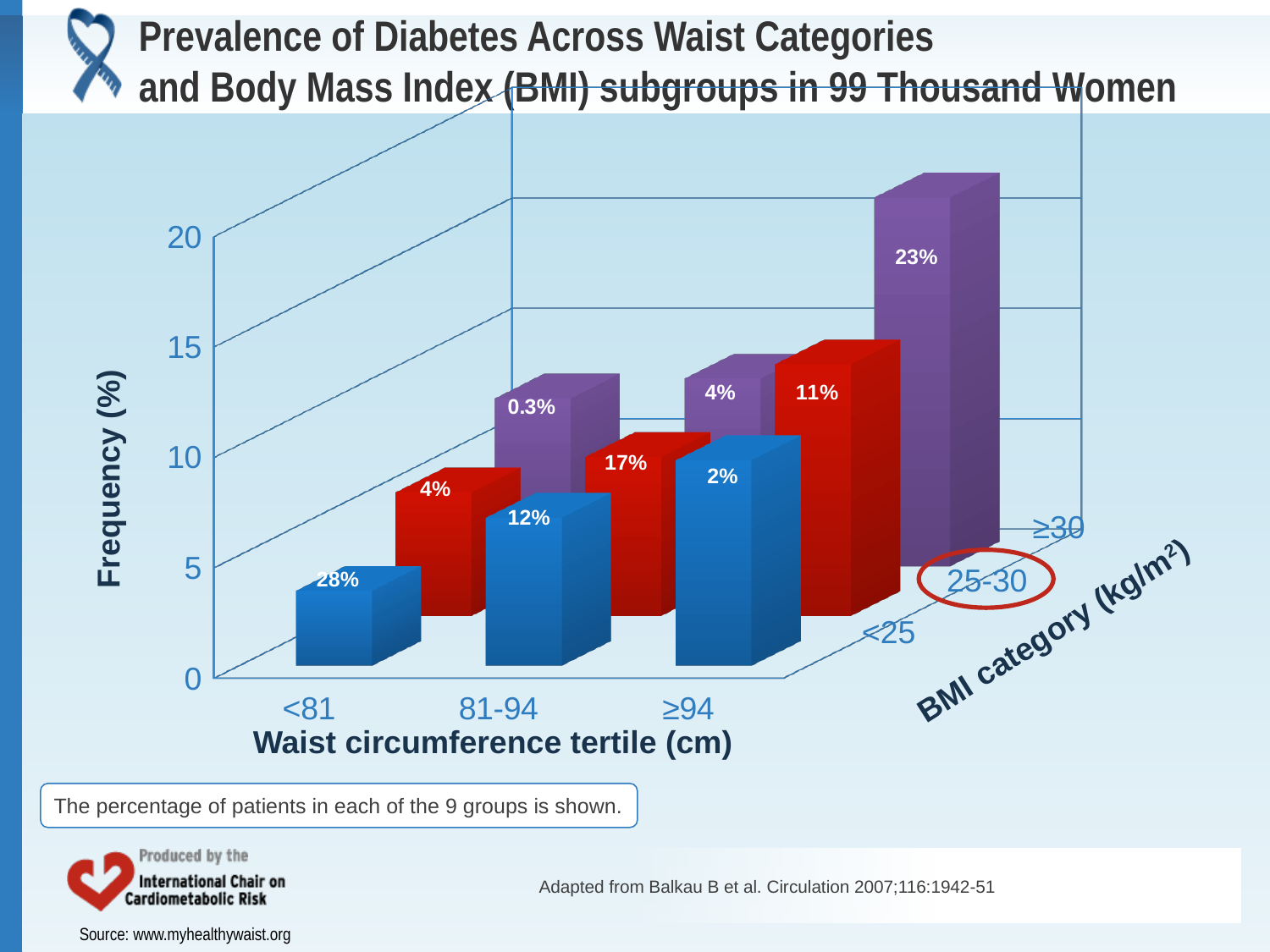
How many waist circumference tertile categories are shown on the x axis? 3 Is the frequency for the <81 waist tertile in the <25 BMI category greater or less than 5? less Which BMI category is circled in red on the chart? 25-30 What kind of chart is shown on the slide? bar chart Is the bar for the ≥94 waist tertile in the 25-30 BMI category taller or shorter than the bar for the <81 waist tertile in the 25-30 BMI category? taller What percentage of patients is printed on the bar for the ≥94 waist tertile in the ≥30 BMI category? 23% What is the label of the vertical axis? Frequency (%) Which combination of waist tertile and BMI category has the shortest bar? <81 cm and <25 kg/m² What percentage of patients is printed on the bar for the 81-94 waist tertile in the ≥30 BMI category? 0.3% Which combination of waist tertile and BMI category has the tallest bar? ≥94 cm and ≥30 kg/m² Is the frequency for the ≥94 waist tertile in the ≥30 BMI category greater or less than 15? greater How many bars are plotted in the chart in total? 9